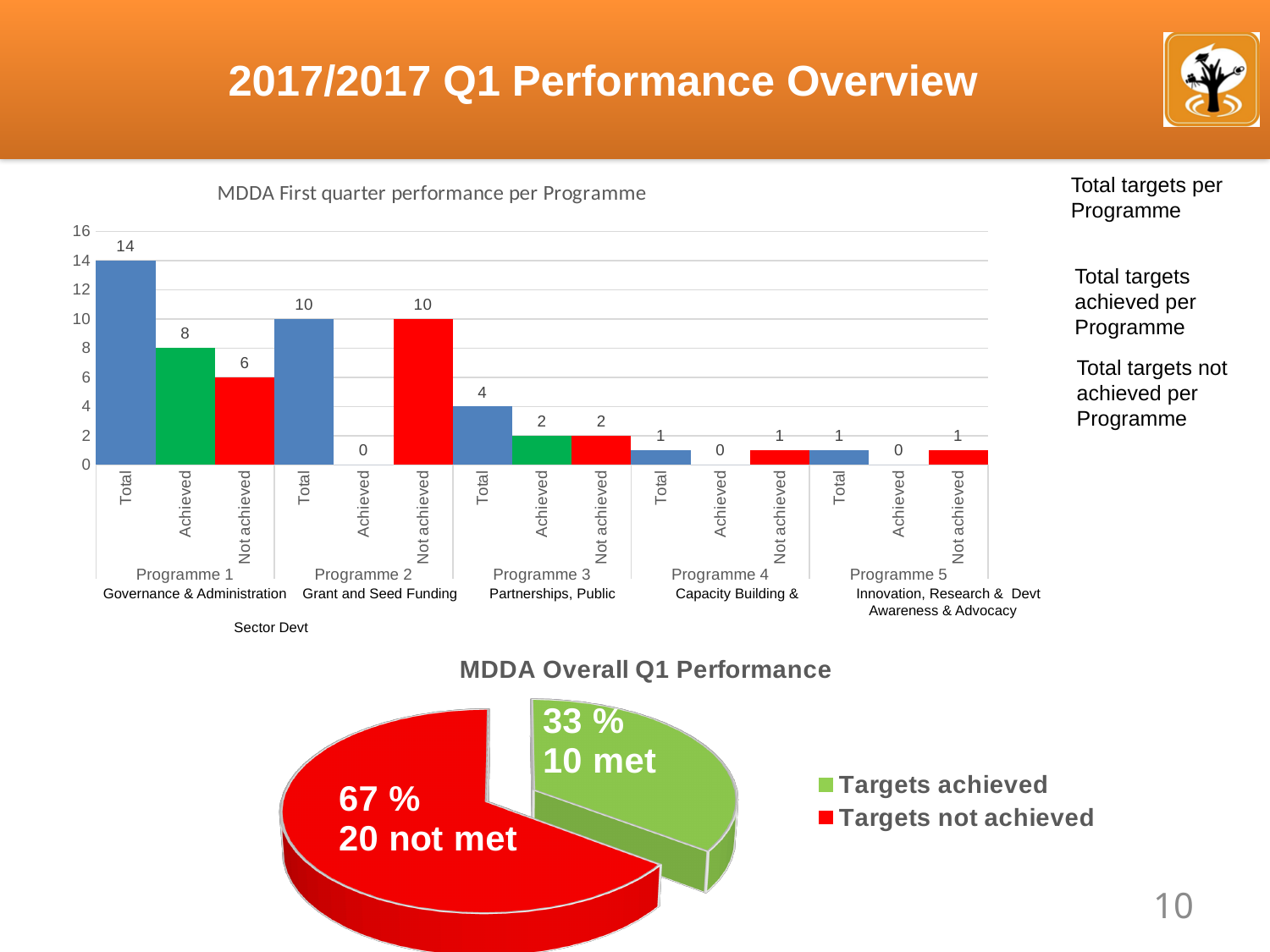
In the 'MDDA First quarter performance per Programme' chart, how many programmes are shown? 5 In the 'MDDA Overall Q1 Performance' chart, how many targets were not met? 20 In the 'MDDA First quarter performance per Programme' chart, which programme has the highest Total? Programme 1 In the 'MDDA First quarter performance per Programme' chart, what is the Achieved value for Programme 3? 2 What kind of chart is 'MDDA First quarter performance per Programme'? Bar chart In the 'MDDA Overall Q1 Performance' chart, what share of targets were achieved? 33 % In the 'MDDA First quarter performance per Programme' chart, how many targets were Not achieved for Programme 2? 10 What kind of chart is 'MDDA Overall Q1 Performance'? Pie chart In the 'MDDA First quarter performance per Programme' chart, which is larger: the Achieved value for Programme 1 or the Not achieved value for Programme 2? Not achieved for Programme 2 In the 'MDDA First quarter performance per Programme' chart, what is the Total value for Programme 1? 14 How many entries does the legend of the 'MDDA Overall Q1 Performance' chart list? 2 In the 'MDDA First quarter performance per Programme' chart, what is the difference between the Achieved and Not achieved values for Programme 1? 2